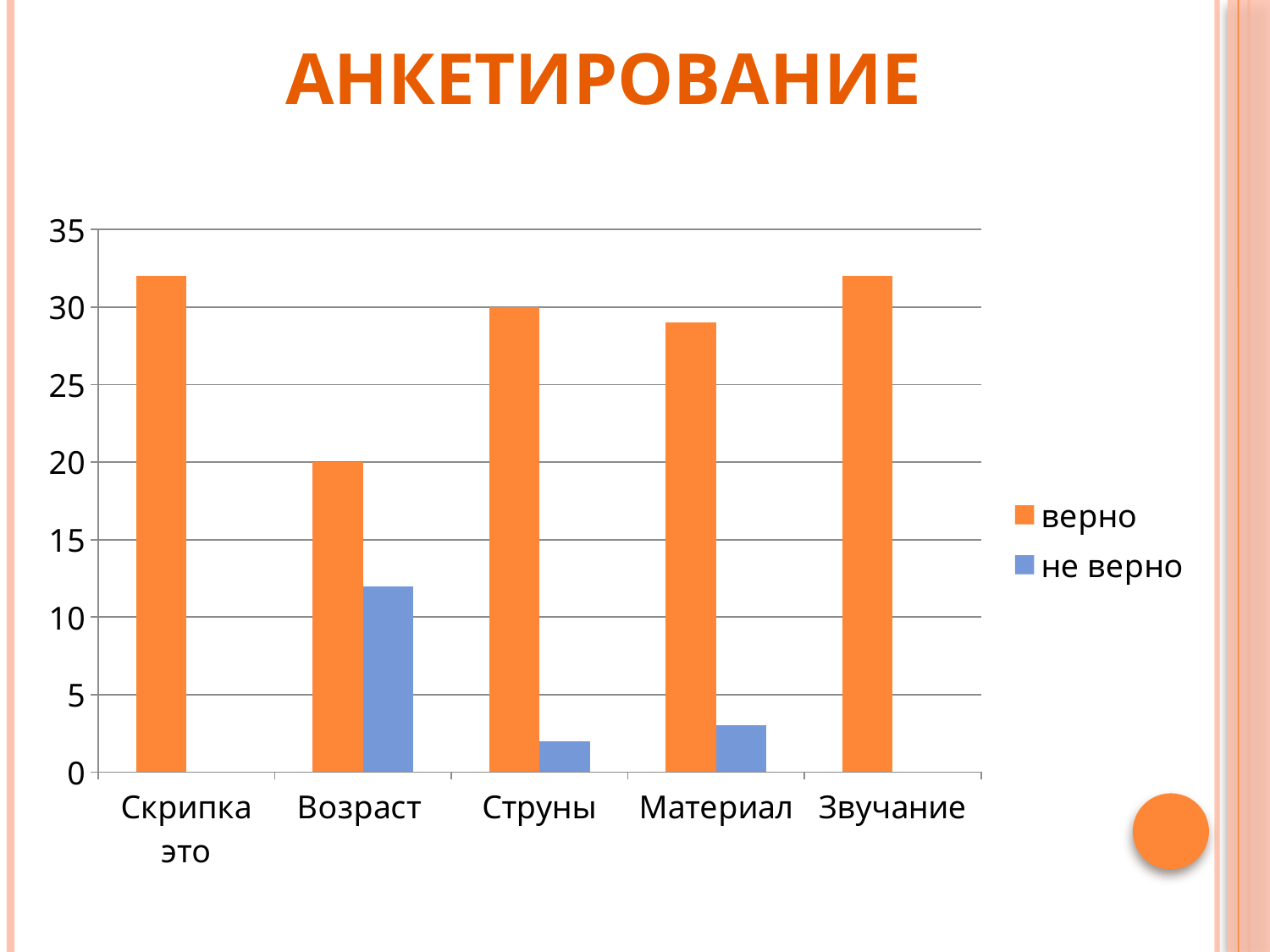
What type of chart is shown on the slide? bar chart How many series does the legend list? 2 Is the не верно value for Возраст greater or less than 10? greater How many categories are shown on the x axis? 5 What is the value of the верно series for Струны? 30 Which category has the highest value in the не верно series? Возраст Is the верно value for Скрипка это greater or less than 30? greater Which category has the lowest value in the верно series? Возраст Is the верно value for Материал greater or less than 25? greater What is the value of the верно series for Возраст? 20 Which is larger: the не верно value for Возраст or the не верно value for Материал? Возраст